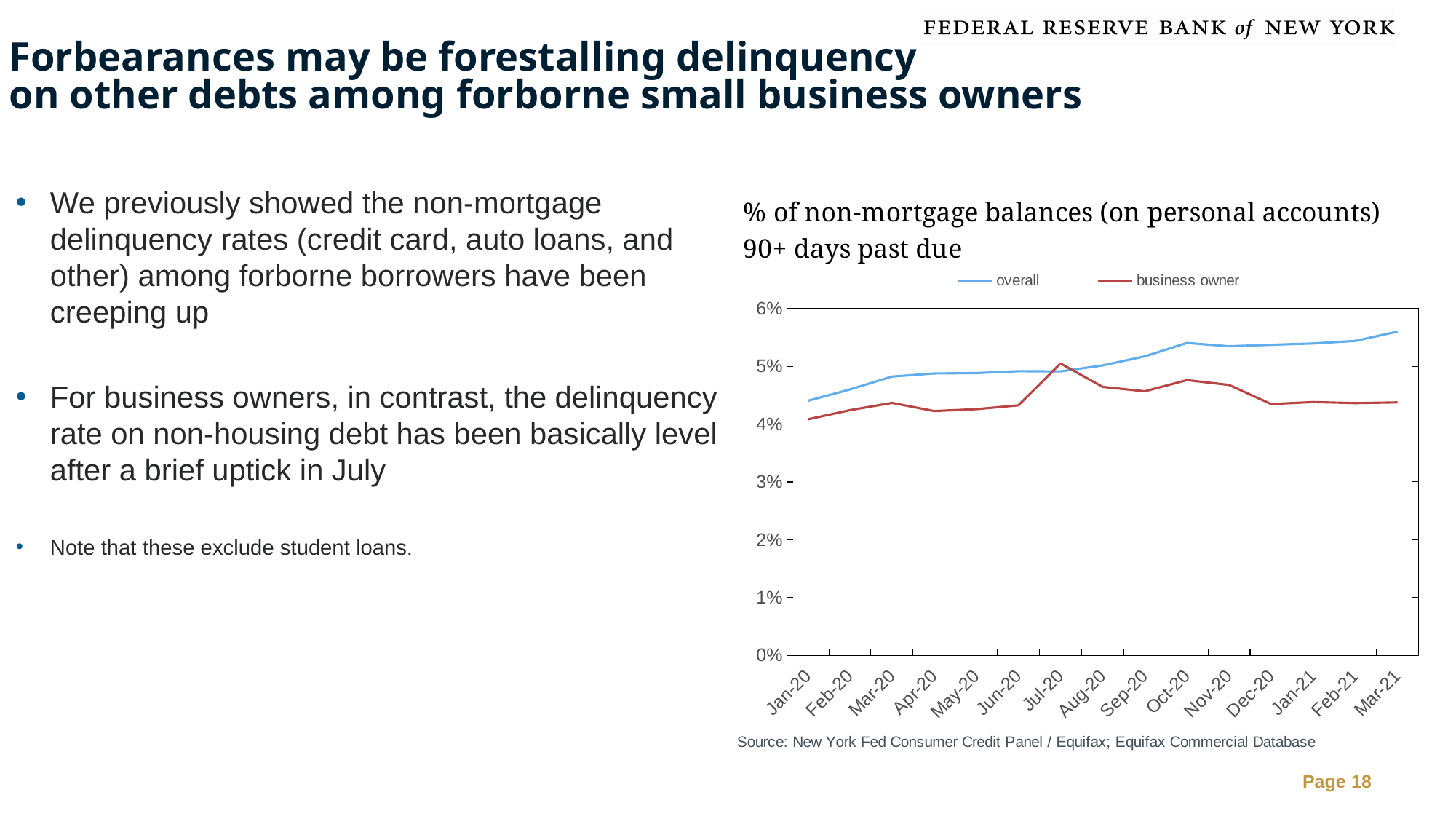
In Mar-21, which series has the larger value, overall or business owner? overall How many series does the chart's legend list? 2 Does the overall series generally rise or fall from Jan-20 to Mar-21? rise Is the value for the business owner series in Dec-20 greater or less than 5%? less Which month has the highest value for the overall series? Mar-21 What kind of chart is shown on the slide? line chart Which month has the lowest value for the overall series? Jan-20 Is the value for the overall series in Mar-21 greater or less than 5%? greater How many months are plotted along the x axis of the chart? 15 Which month has the highest value for the business owner series? Jul-20 What is the title of the chart? % of non-mortgage balances (on personal accounts) 90+ days past due What are the two series named in the chart's legend? overall and business owner